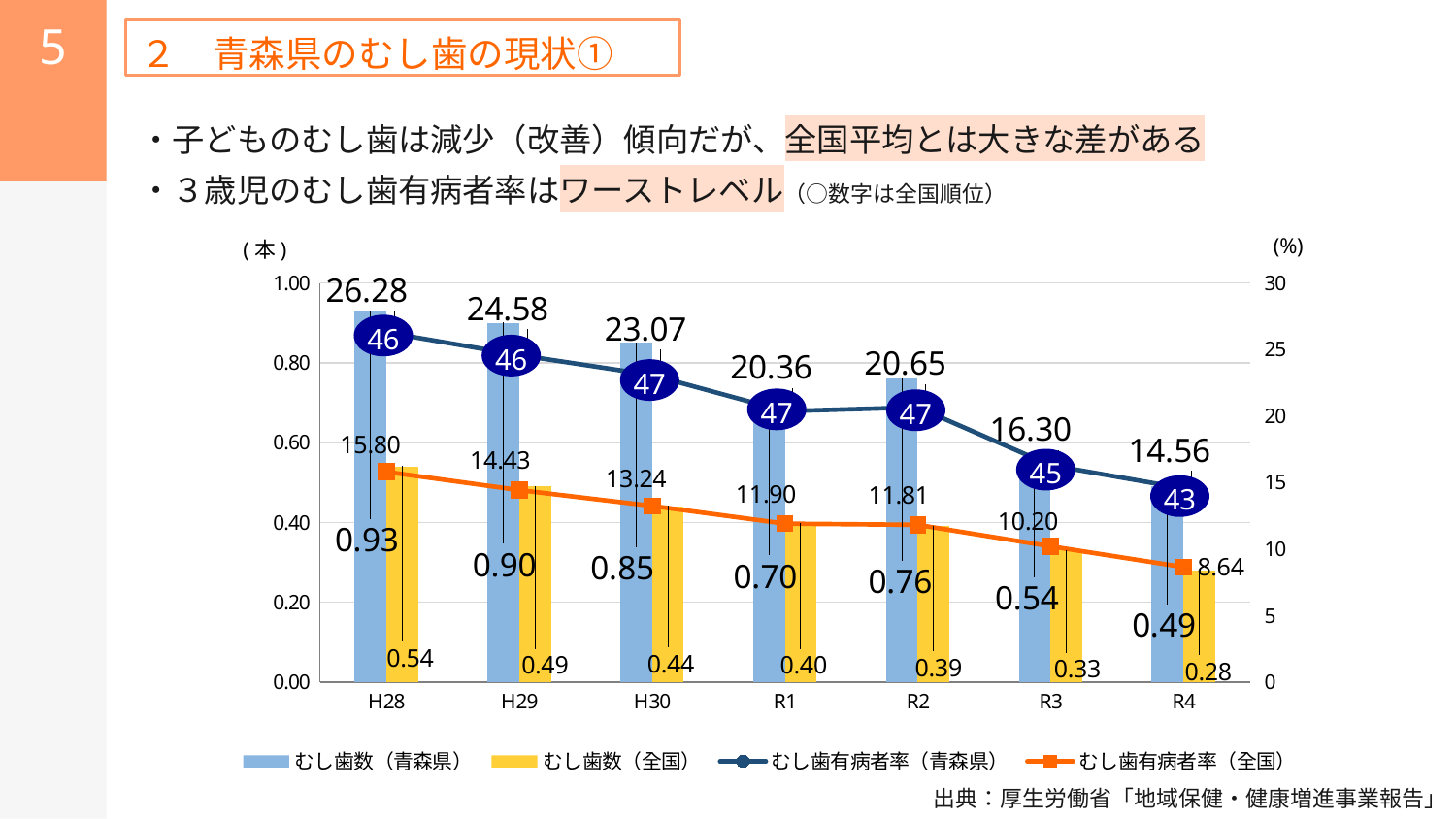
R3の青森県の全国順位（○数字）はいくつですか？ 45 H28からR4にかけて、むし歯有病者率（全国）は上昇していますか、下降していますか？ 下降 むし歯数（青森県）が最も低いのはどの年度ですか？ R4 R1とR2では、むし歯有病者率（青森県）はどちらが高いですか？ R2 R4のむし歯有病者率（全国）の値はいくつですか？ 8.64 むし歯有病者率（青森県）が最も高いのはどの年度ですか？ H28 R2のむし歯数（青森県）と（全国）の差はいくつですか？ 0.37 H30のむし歯有病者率（青森県）と（全国）の差はいくつですか？ 9.83 横軸には何年度分のカテゴリがありますか？ 7 凡例にはいくつの系列が示されていますか？ 4 H28のむし歯数（青森県）の値はいくつですか？ 0.93 R1のむし歯数（全国）の値はいくつですか？ 0.40